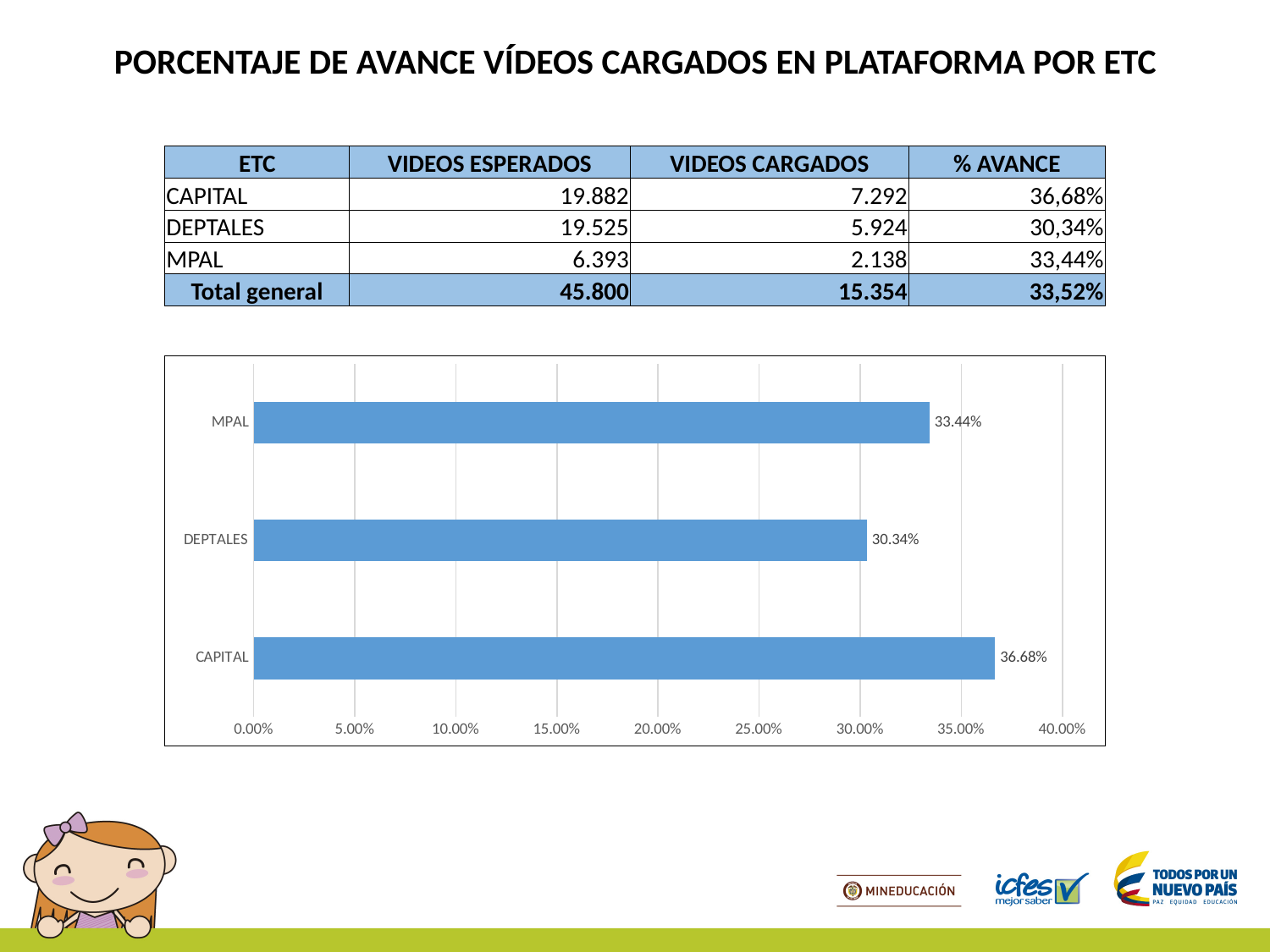
What is the highest value shown on the x axis of the chart? 40.00% Is the value for DEPTALES in the chart greater or less than 35.00%? less What is the value shown for DEPTALES in the chart? 30.34% Which is larger in the chart, the value for MPAL or the value for DEPTALES? MPAL How many categories are shown in the chart? 3 What is the difference between the values for MPAL and DEPTALES in the chart? 3.10% Which category has the highest value in the chart? CAPITAL What is the difference between the values for CAPITAL and DEPTALES in the chart? 6.34% What is the value shown for MPAL in the chart? 33.44% Which category has the lowest value in the chart? DEPTALES What is the value shown for CAPITAL in the chart? 36.68% What kind of chart is shown on the slide? bar chart